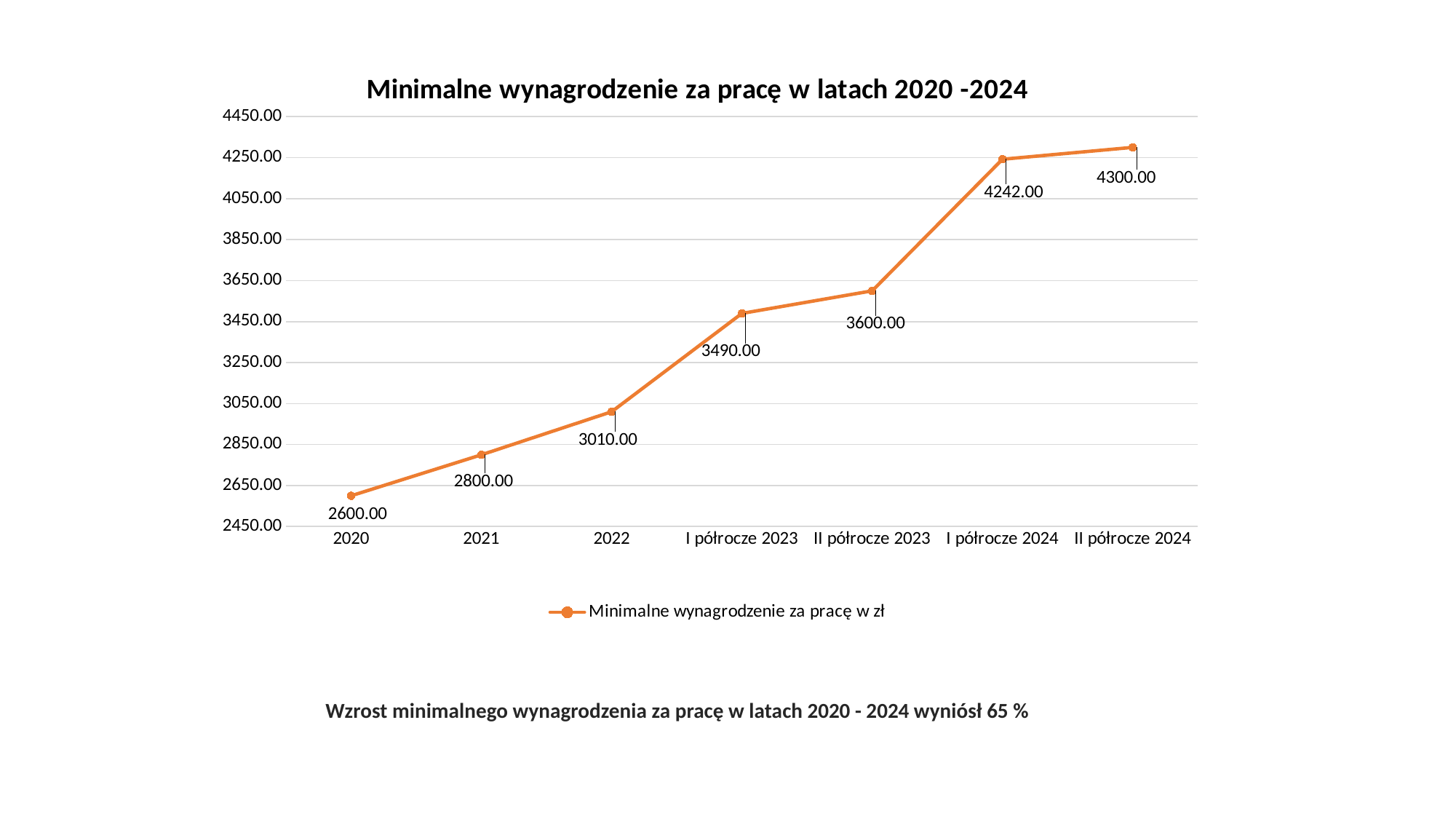
What is the value for 2022? 3010.00 Do the values rise or fall from 2020 to II półrocze 2024? rise How many data points are plotted on the chart? 7 What is the value for I półrocze 2023? 3490.00 Which category has the highest value? II półrocze 2024 Which category has the lowest value? 2020 What is the value for 2020? 2600.00 What is the difference between the values for I półrocze 2024 and II półrocze 2023? 642.00 What is the value for II półrocze 2024? 4300.00 How many series does the legend list? 1 Which is larger, the value for 2021 or the value for 2022? 2022 What kind of chart is shown? line chart